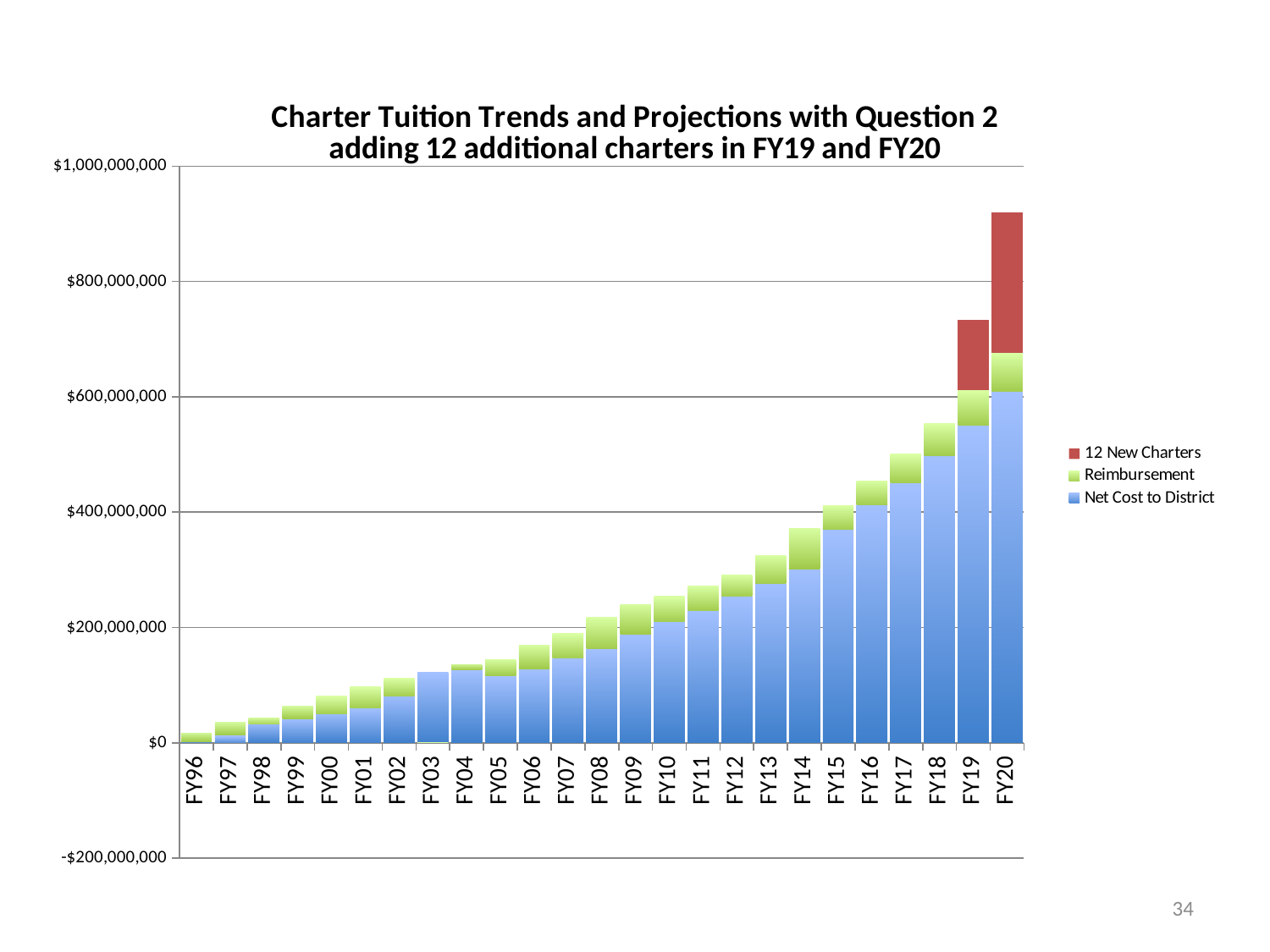
What kind of chart is shown on the slide? Stacked bar chart Which fiscal year has the shortest stacked bar? FY96 Is the total stacked value for FY20 greater or less than $800,000,000? greater Is the total stacked value for FY19 greater or less than $600,000,000? greater How many fiscal years are shown on the x axis? 25 Which series is shown in red in the legend? 12 New Charters Which fiscal year has the tallest stacked bar? FY20 Do the stacked bar totals generally rise or fall from FY96 to FY20? Rise Which is larger, the total stacked value for FY19 or for FY18? FY19 Is the total stacked value for FY18 greater or less than $600,000,000? less How many series does the legend list? 3